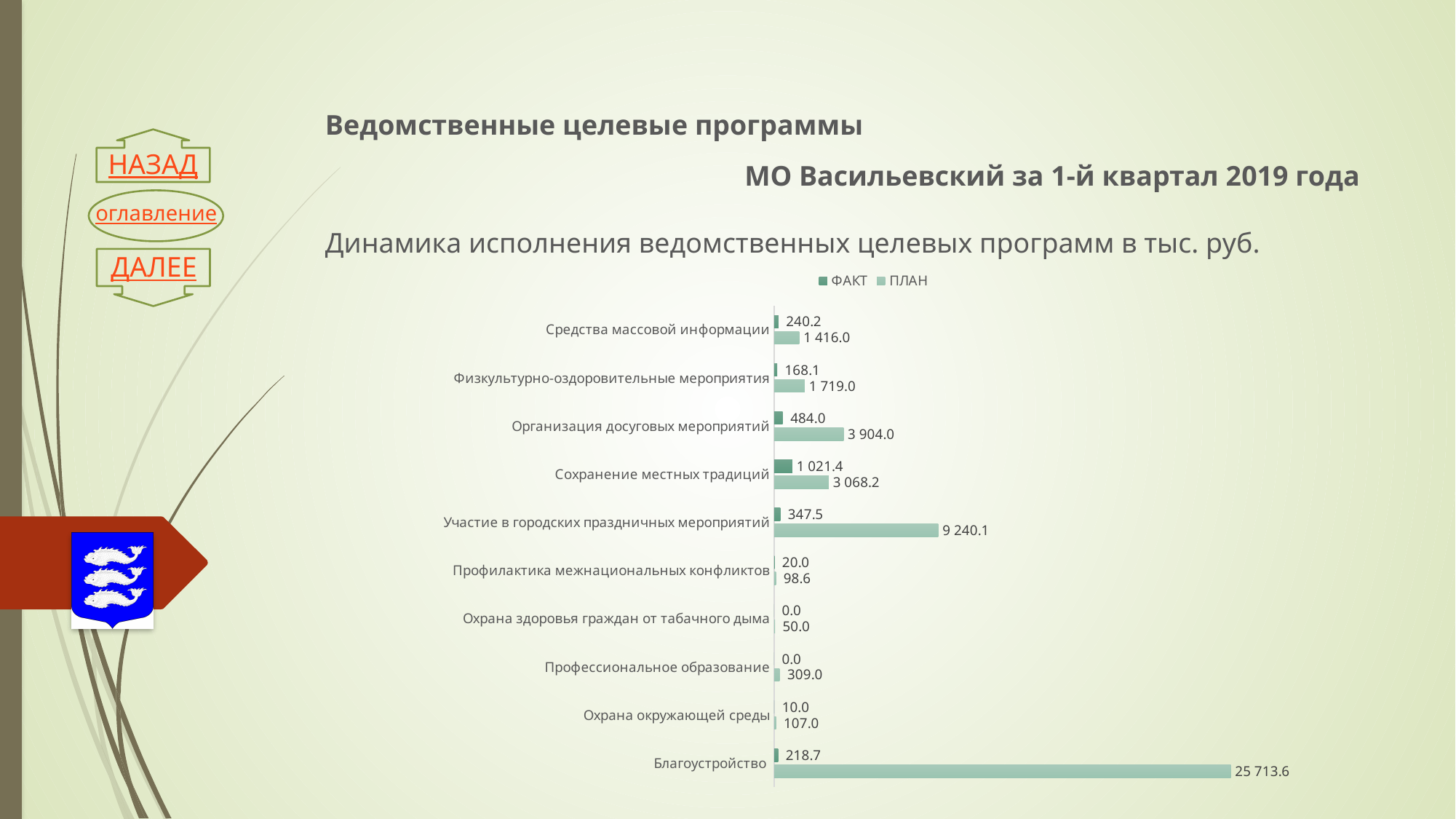
How many categories (programs) are shown in the chart? 10 What is the ФАКТ value for Сохранение местных традиций? 1 021.4 What is the ФАКТ value for Профессиональное образование? 0.0 What is the ПЛАН value for Участие в городских праздничных мероприятиях? 9 240.1 What type of chart is shown on the slide? Bar chart Which category has the highest ПЛАН value? Благоустройство Which is larger: the ФАКТ value for Организация досуговых мероприятий or the ФАКТ value for Средства массовой информации? Организация досуговых мероприятий Which category has the highest ФАКТ value? Сохранение местных традиций What is the ПЛАН value for Благоустройство? 25 713.6 Which category has the lowest ПЛАН value? Охрана здоровья граждан от табачного дыма How many series does the legend list? 2 What is the difference between the ПЛАН and ФАКТ values for Сохранение местных традиций? 2 046.8